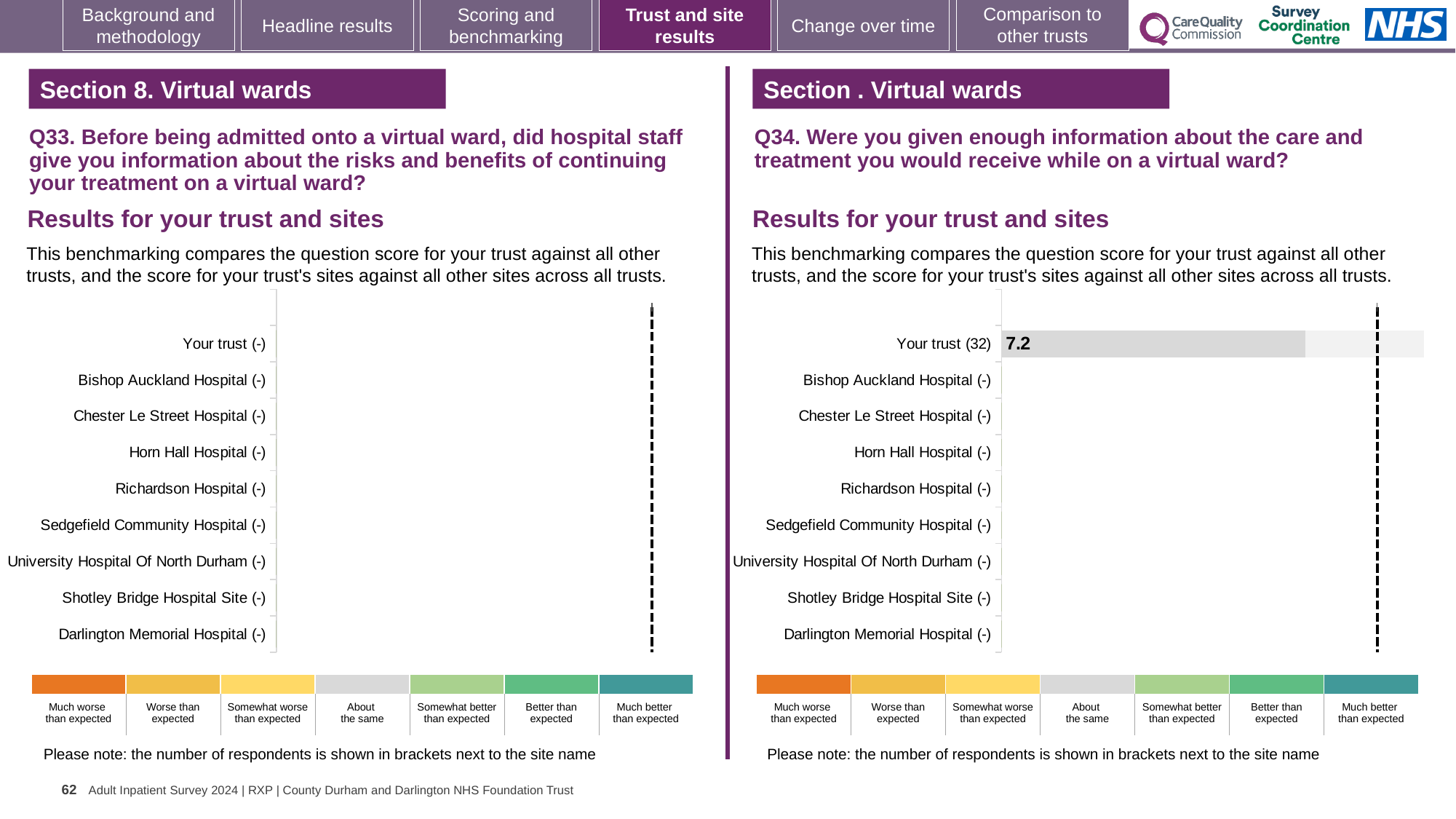
On the right chart (Q34), how many bars have a plotted value? 1 On the right chart (Q34), how many categories are listed on the vertical axis? 9 On the right chart (Q34), which category is the only one with a plotted bar? Your trust On the left chart (Q33), how many bars have a plotted value? 0 On the right chart (Q34), what is the score shown for Your trust? 7.2 On the right chart (Q34), how many respondents are shown in brackets next to Your trust? 32 How many colour bands are shown in the key beneath each chart? 7 What kind of chart is used on the right side of the slide (Q34)? Bar chart